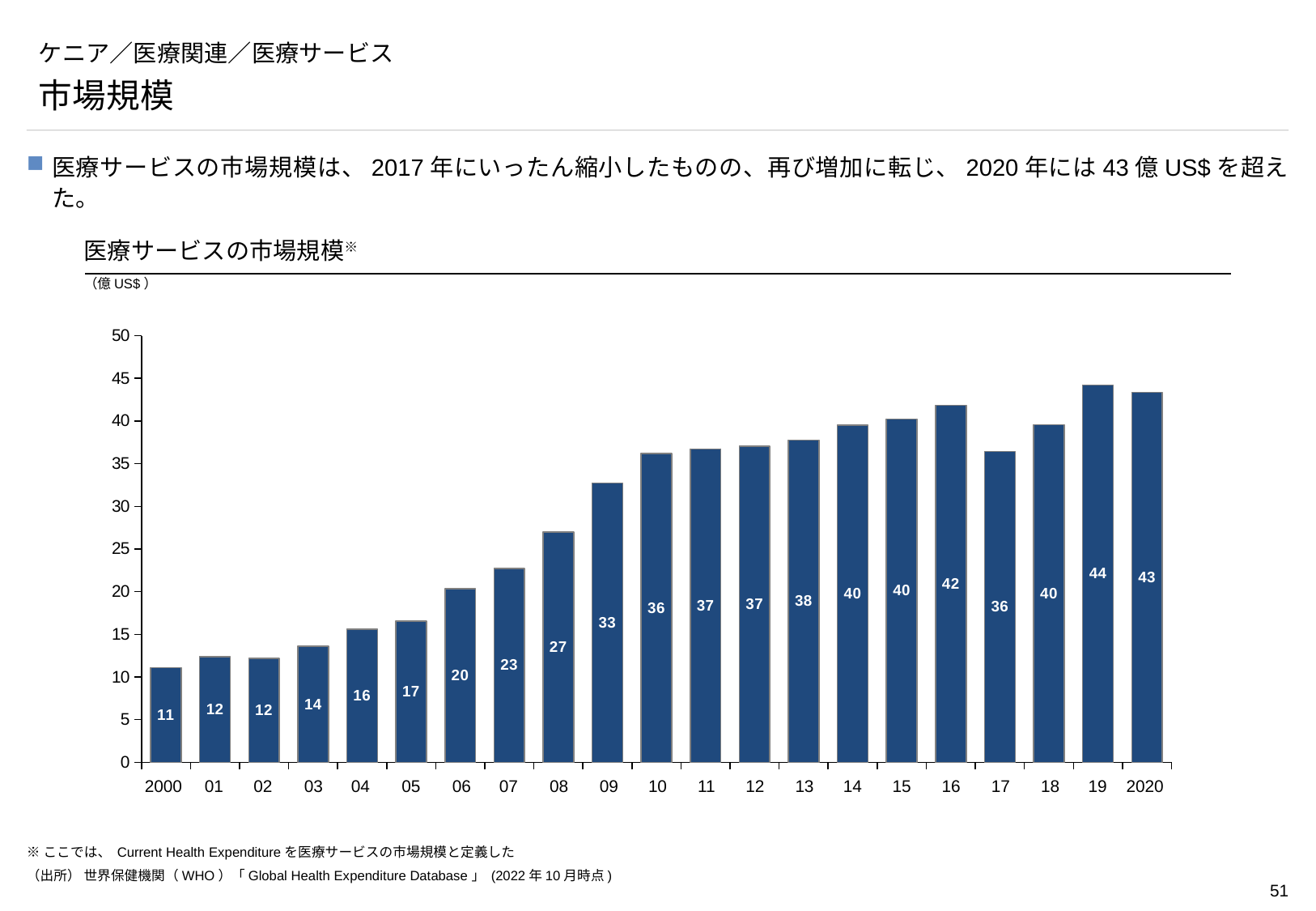
How many years are plotted in the chart? 21 What is the value for 2009? 33 What is the value for 2000? 11 Which is larger, the value for 2016 or the value for 2017? 2016 Which year has the highest value? 2019 What is the value for 2020 in the 医療サービスの市場規模 chart? 43 What is the difference between the values for 2019 and 2017? 8 What is the value for 2017? 36 Which year has the lowest value? 2000 What unit is shown for the chart's values? 億US$ Do the values generally rise or fall from 2000 to 2020? rise What type of chart is shown on the slide? bar chart